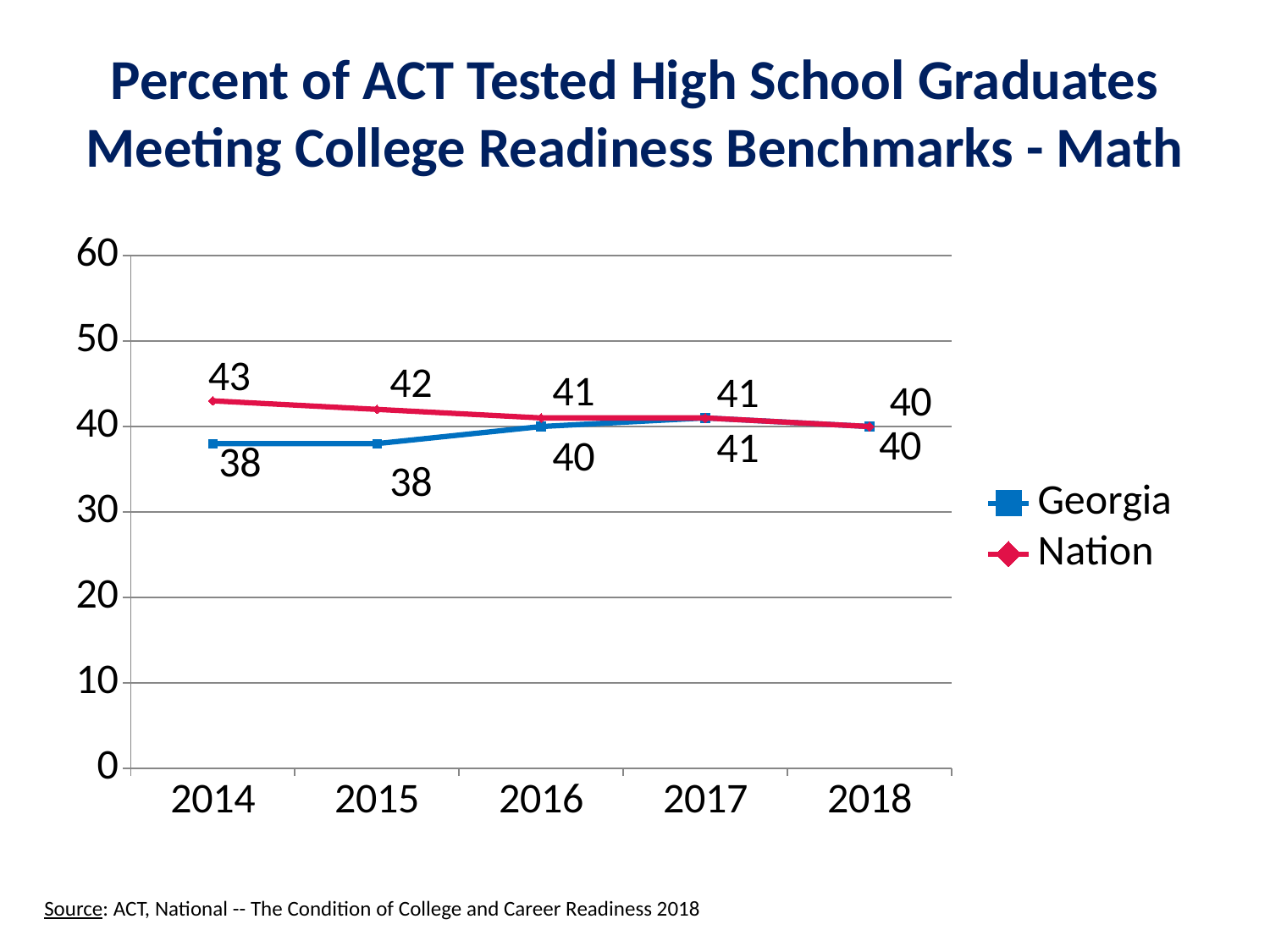
How many series does the legend list? 2 How many years are shown on the x axis? 5 What is the value for Georgia in 2014? 38 What is the difference between the Nation and Georgia values in 2014? 5 What is the difference between the Nation and Georgia values in 2015? 4 What is the value for Georgia in 2016? 40 Which is larger in 2015, the Georgia value or the Nation value? Nation In which year is the Nation value highest? 2014 What is the value for Nation in 2014? 43 What is the value for Nation in 2018? 40 What kind of chart is shown? Line chart Does the Nation series rise or fall from 2014 to 2018? Fall